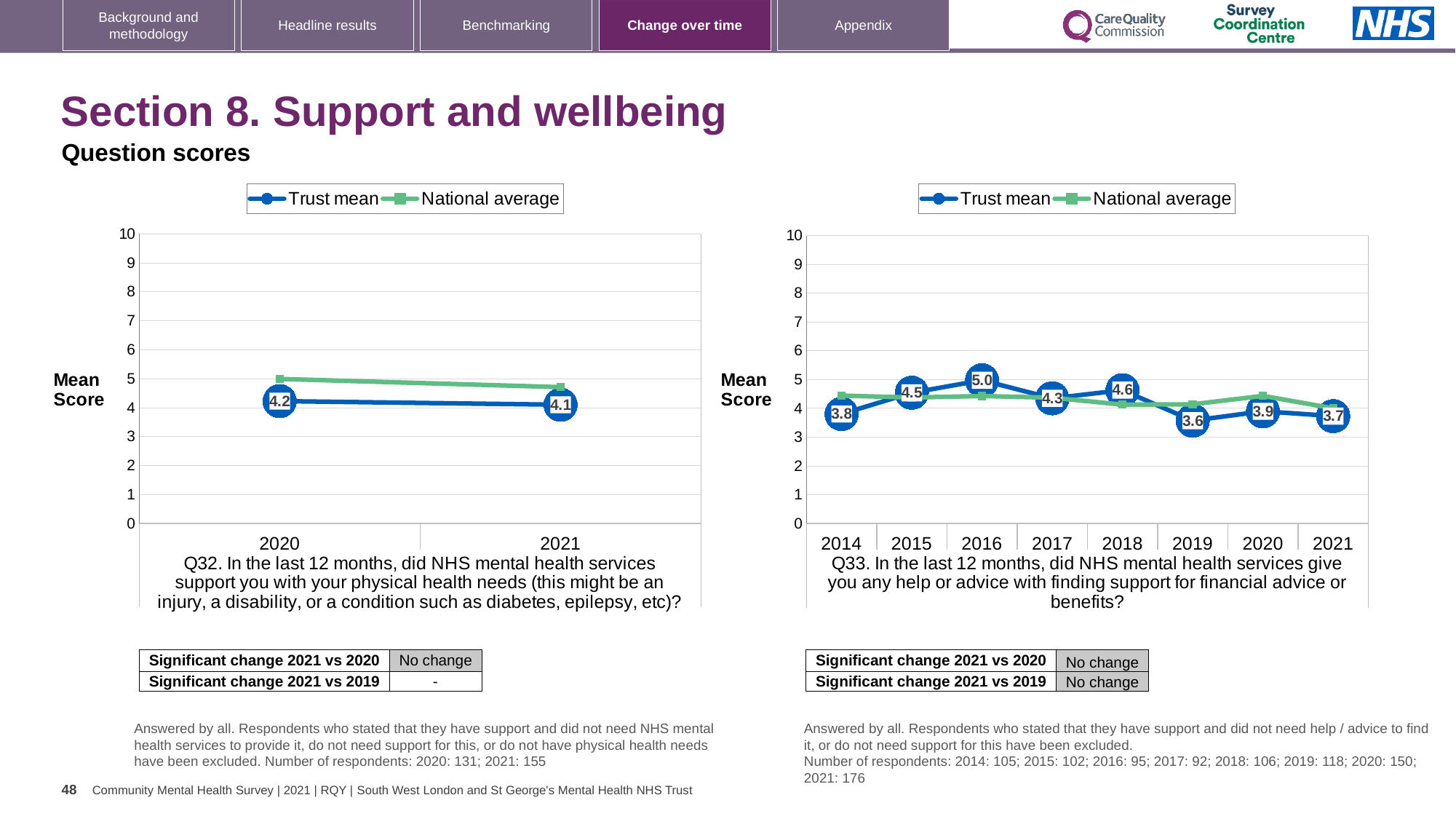
In the Q33 chart on the right, what is the Trust mean for 2019? 3.6 In the Q33 chart on the right, what is the Trust mean for 2016? 5.0 In the Q32 chart on the left, how many series does the legend list? 2 In the Q32 chart on the left, what is the Trust mean for 2020? 4.2 In the Q33 chart on the right, which year has the lowest Trust mean? 2019 In the Q33 chart on the right, what is the difference between the Trust mean for 2016 and the Trust mean for 2019? 1.4 In the Q33 chart on the right, which year has the highest Trust mean? 2016 In the Q32 chart on the left, what is the Trust mean for 2021? 4.1 In the Q33 chart on the right, how many years are plotted on the x axis? 8 What type of chart is the Q33 chart on the right? Line chart In the Q33 chart on the right, is the Trust mean for 2018 larger than the Trust mean for 2021? Yes, 2018 (4.6) is larger than 2021 (3.7) In the Q32 chart on the left, is the National average for 2020 greater or less than 4? greater